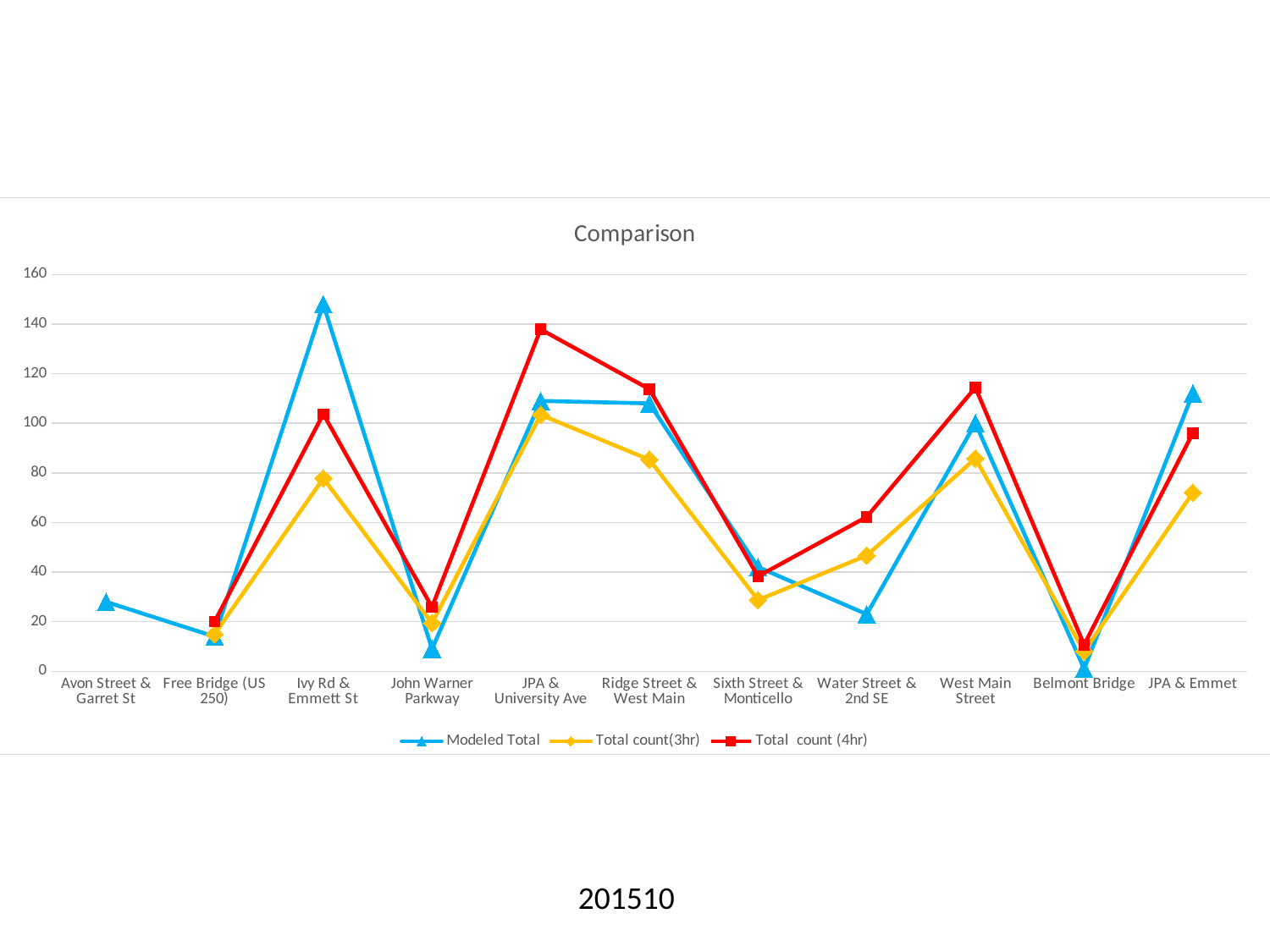
How many series does the legend list? 3 At Ivy Rd & Emmett St, which is larger: Modeled Total or Total count (4hr)? Modeled Total Is the Total count(3hr) value for Water Street & 2nd SE greater or less than 60? less What is the title of the chart? Comparison How many categories are shown along the x axis? 11 Is the Modeled Total value for Ivy Rd & Emmett St greater or less than 140? greater For the Modeled Total series, which category has the lowest value? Belmont Bridge For the Total count (4hr) series, which category has the highest value? JPA & University Ave At Water Street & 2nd SE, which is larger: Modeled Total or Total count (4hr)? Total count (4hr) Does the Modeled Total series rise or fall from Belmont Bridge to JPA & Emmet? rise For the Modeled Total series, which category has the highest value? Ivy Rd & Emmett St What kind of chart is shown on the slide? Line chart